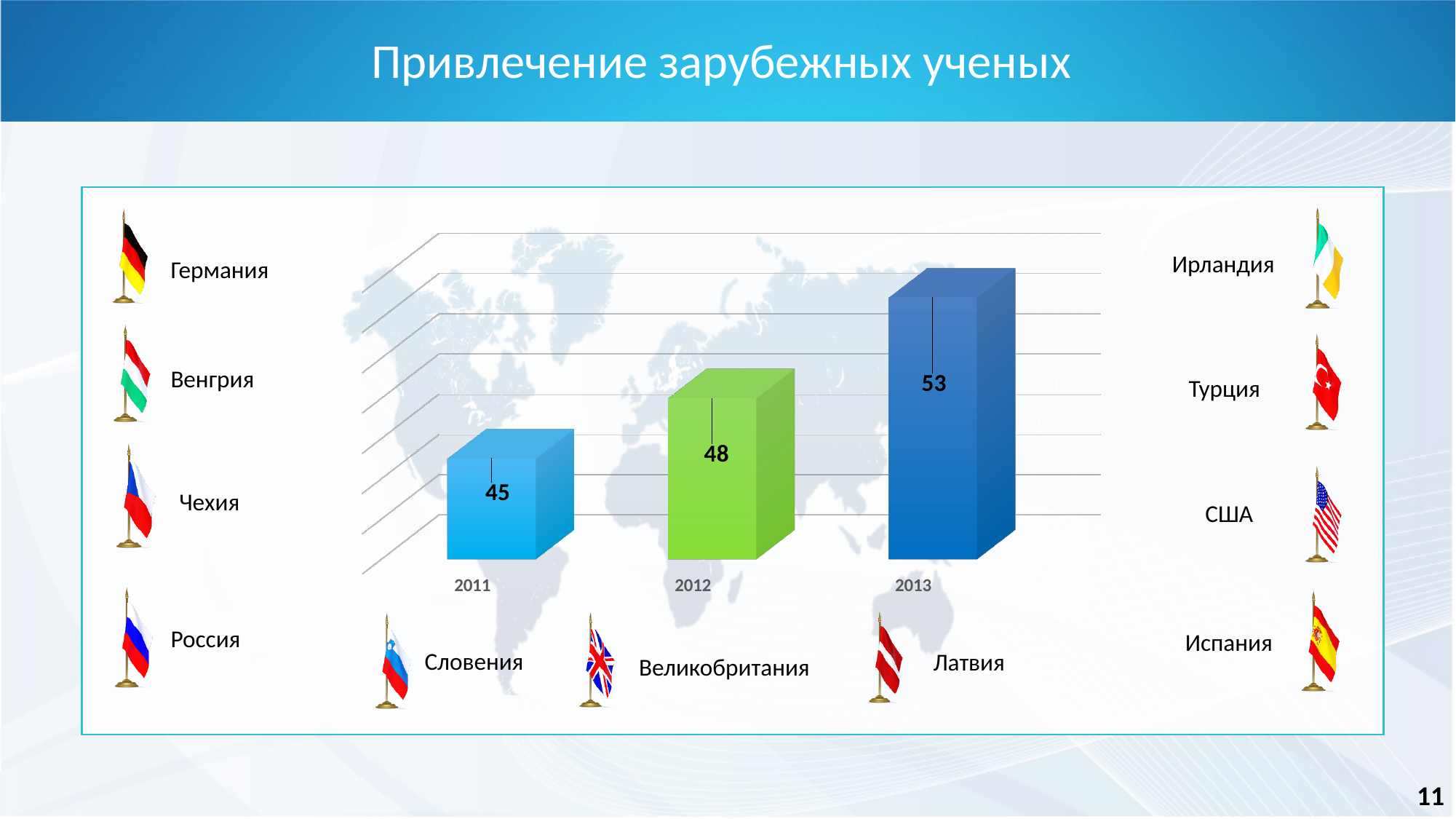
Which is larger, the value for 2012 or the value for 2013? 2013 What is the value for 2012? 48 How many years are shown on the x axis of the chart? 3 What is the value for 2011? 45 What is the difference between the values for 2013 and 2011? 8 Which year has the lowest value? 2011 Which year has the highest value? 2013 What is the value for 2013? 53 Do the values rise or fall from 2011 to 2013? rise What is the title of the slide containing the chart? Привлечение зарубежных ученых What kind of chart is shown on the slide? bar chart What is the difference between the values for 2012 and 2011? 3